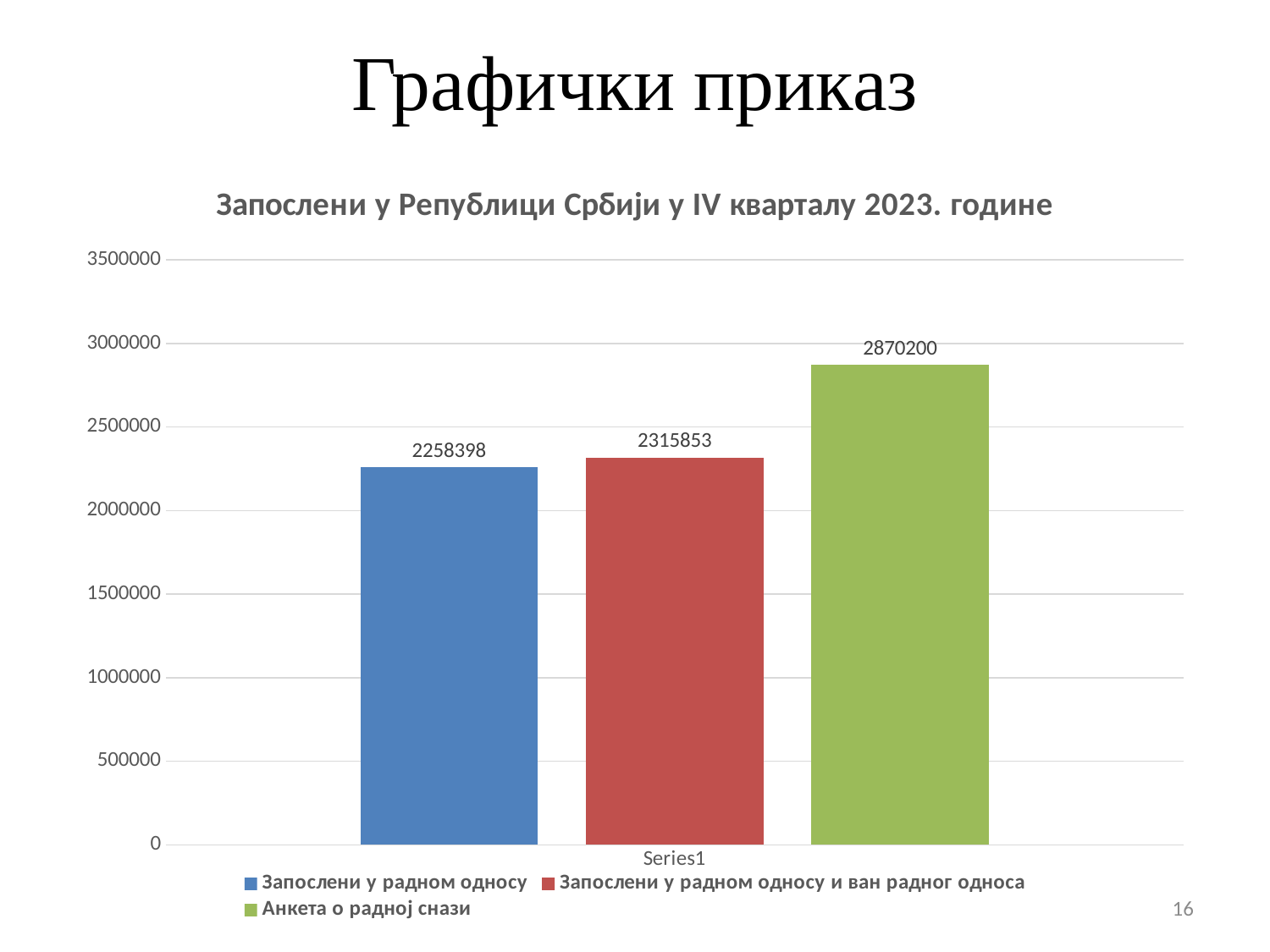
Which series has the highest value? Анкета о радној снази What is the value for Запослени у радном односу? 2258398 What is the value for Анкета о радној снази? 2870200 Is the value for Анкета о радној снази greater or less than 3000000? less What kind of chart is shown on the slide? bar chart What is the title of the chart? Запослени у Републици Србији у IV кварталу 2023. године How many series does the legend list? 3 What is the value for Запослени у радном односу и ван радног односа? 2315853 What is the difference between the value for Анкета о радној снази and the value for Запослени у радном односу? 611802 What is the difference between the value for Запослени у радном односу и ван радног односа and the value for Запослени у радном односу? 57455 Which is larger: the value for Запослени у радном односу or the value for Запослени у радном односу и ван радног односа? Запослени у радном односу и ван радног односа Which series has the lowest value? Запослени у радном односу